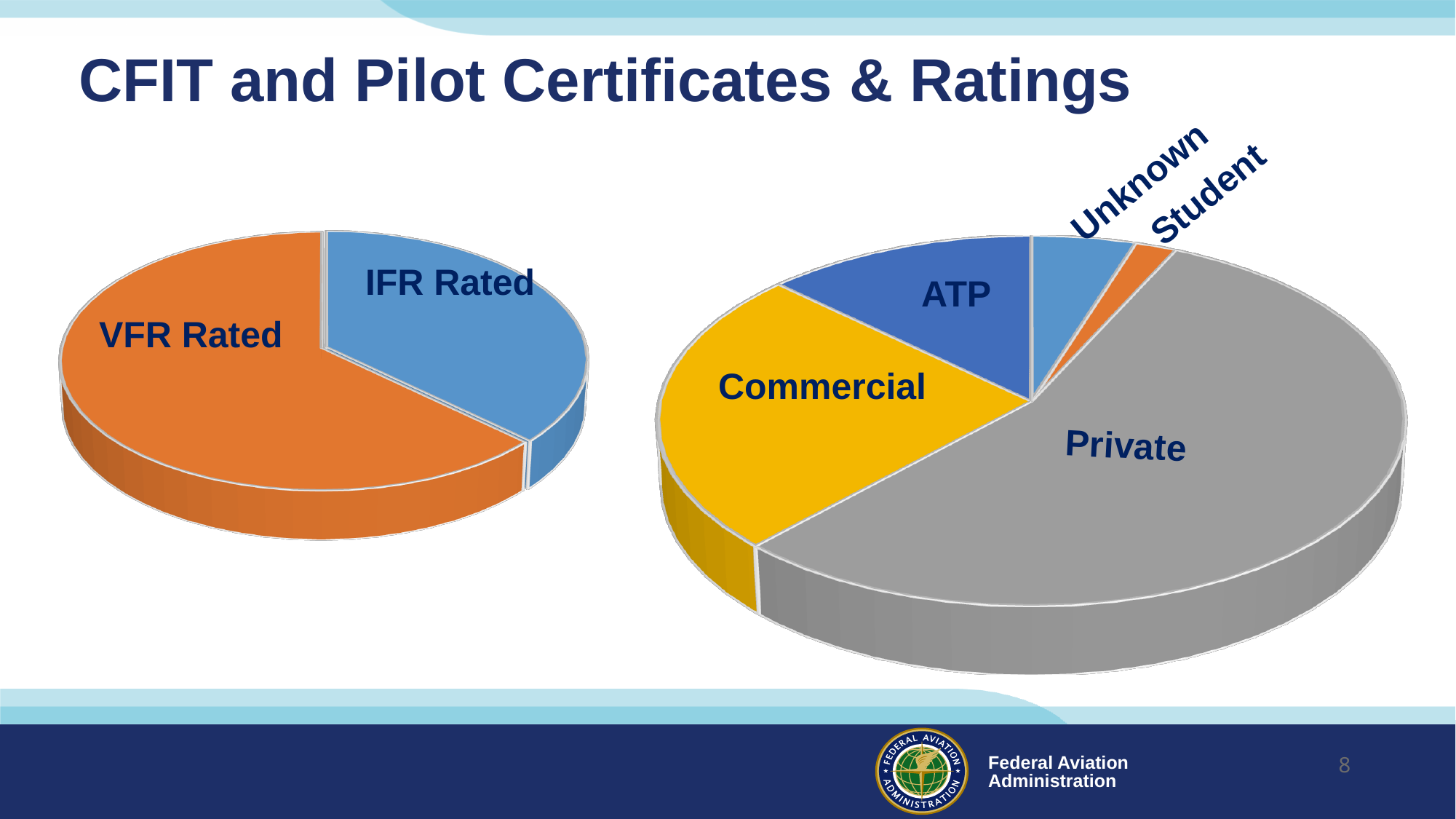
What kind of chart is the left chart on the slide? pie chart In the right pie chart, which slice is the smallest? Student How many slices does the right pie chart have? 5 In the left pie chart, which slice is the smallest? IFR Rated In the right pie chart, which slice is larger, Unknown or Student? Unknown How many slices does the left pie chart have? 2 In the right pie chart, which slice is larger, Commercial or ATP? Commercial In the left pie chart, which slice is the largest? VFR Rated In the left pie chart, what colour is the VFR Rated slice? orange In the right pie chart, what colour is the Private slice? grey What kind of chart is the right chart on the slide? pie chart In the right pie chart, which slice is the largest? Private